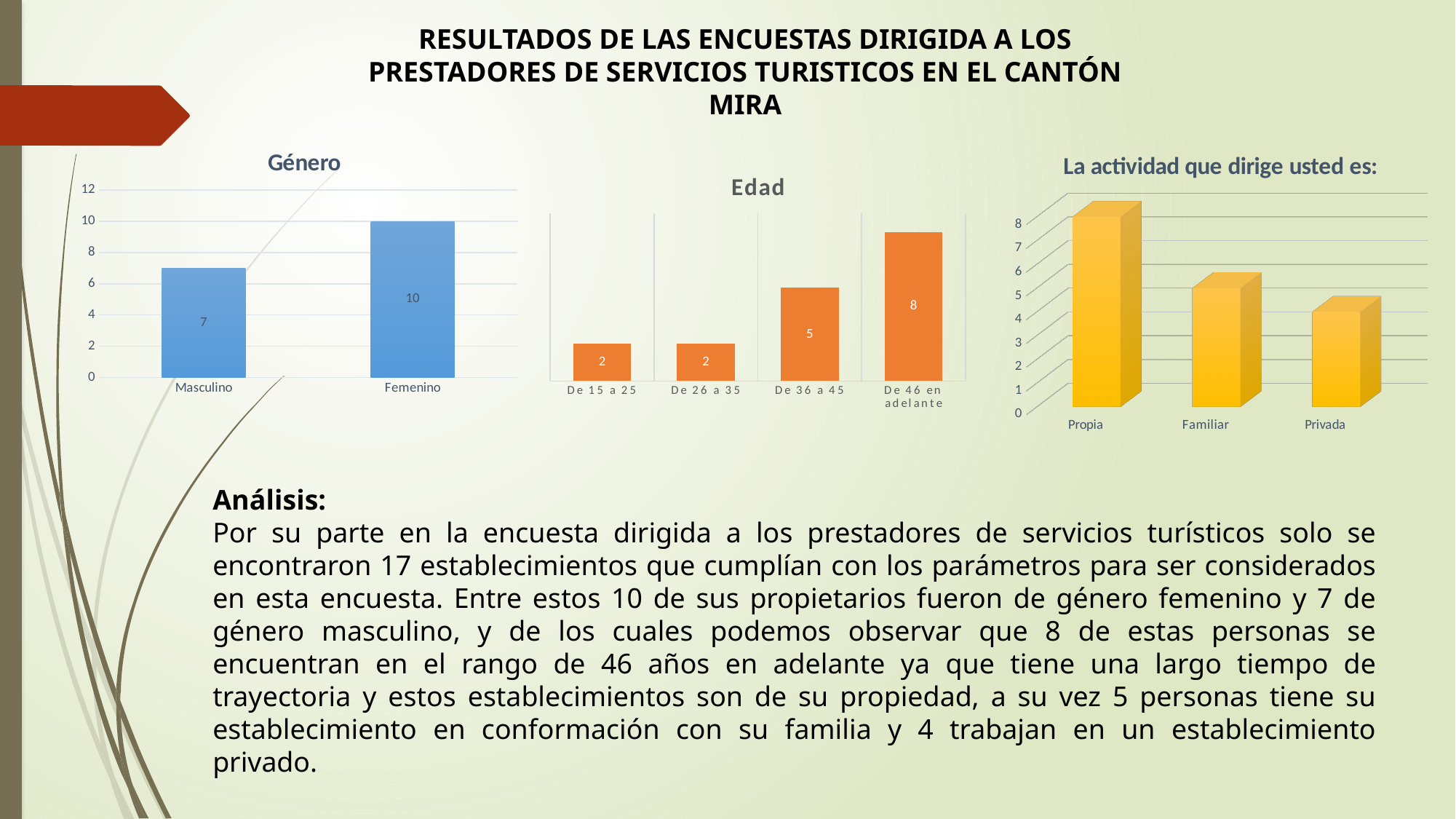
In the Edad chart, what is the value for De 36 a 45? 5 In the Edad chart, how many age categories are shown? 4 In the chart titled 'La actividad que dirige usted es:', which category has the highest value? Propia In the Edad chart, what is the difference between De 46 en adelante and De 15 a 25? 6 In the Edad chart, which age range has the highest value? De 46 en adelante In the Género chart, what is the value for Femenino? 10 What kind of chart is the Edad chart? bar chart In the Género chart, what is the difference between the Femenino and Masculino values? 3 In the Género chart, what is the value for Masculino? 7 In the chart titled 'La actividad que dirige usted es:', is the value for Privada greater or less than 6? less In the Edad chart, do the values rise or fall from left to right along the x axis? rise In the Género chart, which category has the higher value? Femenino